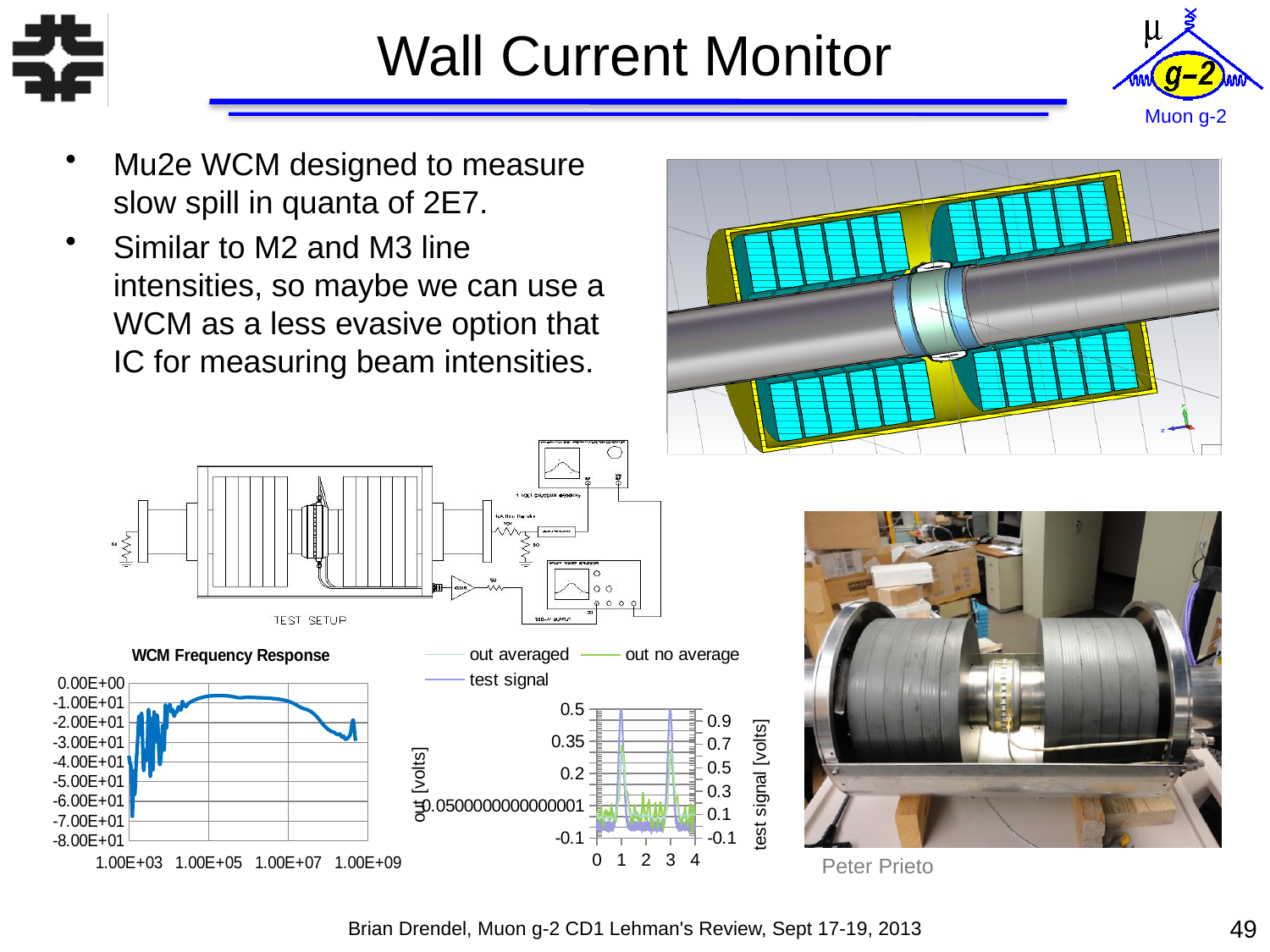
What kind of chart is the chart with the 'out [volts]' and 'test signal [volts]' axes? line chart How many series does the legend of the chart with the 'out [volts]' axis list? 3 What kind of chart is the WCM Frequency Response chart? line chart In the WCM Frequency Response chart, does the curve rise or fall between 1.00E+03 and 1.00E+05 on the x axis? rise In the WCM Frequency Response chart, is the lowest point of the curve greater or less than -6.00E+01? less In the chart with the 'out [volts]' axis, what is the highest tick value shown on the x axis? 4 In the WCM Frequency Response chart, does the curve rise or fall between 1.00E+07 and 1.00E+09 on the x axis? fall In the WCM Frequency Response chart, what is the lowest tick value shown on the x axis? 1.00E+03 In the chart with the 'out [volts]' axis, is the peak of the test signal series greater or less than 0.7 on the right-hand axis? greater In the chart with the 'out [volts]' axis, what is the label of the right-hand y axis? test signal [volts]